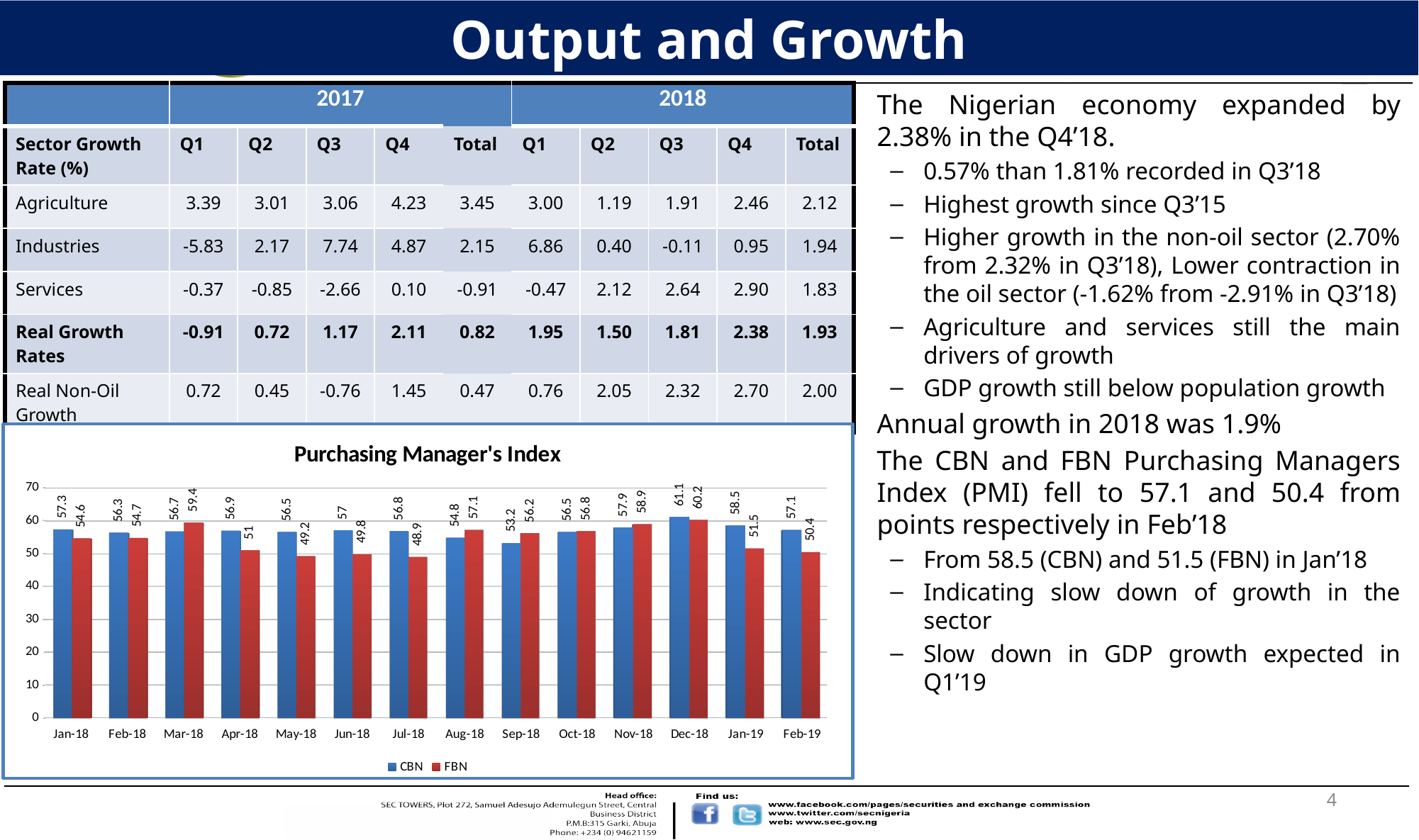
What is the difference between the CBN and FBN values for Jan-19 in the Purchasing Manager's Index chart? 7 What is the CBN value for Dec-18 in the Purchasing Manager's Index chart? 61.1 How many series does the legend of the Purchasing Manager's Index chart list? 2 What is the CBN value for Sep-18 in the Purchasing Manager's Index chart? 53.2 What type of chart is the Purchasing Manager's Index chart? bar chart What is the FBN value for Feb-19 in the Purchasing Manager's Index chart? 50.4 Which colour represents the FBN series in the Purchasing Manager's Index chart? red Is the FBN value for May-18 in the Purchasing Manager's Index chart greater or less than 50? less In Mar-18, which series has the larger value in the Purchasing Manager's Index chart, CBN or FBN? FBN How many months are shown on the x axis of the Purchasing Manager's Index chart? 14 In which month is the CBN value highest in the Purchasing Manager's Index chart? Dec-18 In which month is the FBN value lowest in the Purchasing Manager's Index chart? Jul-18